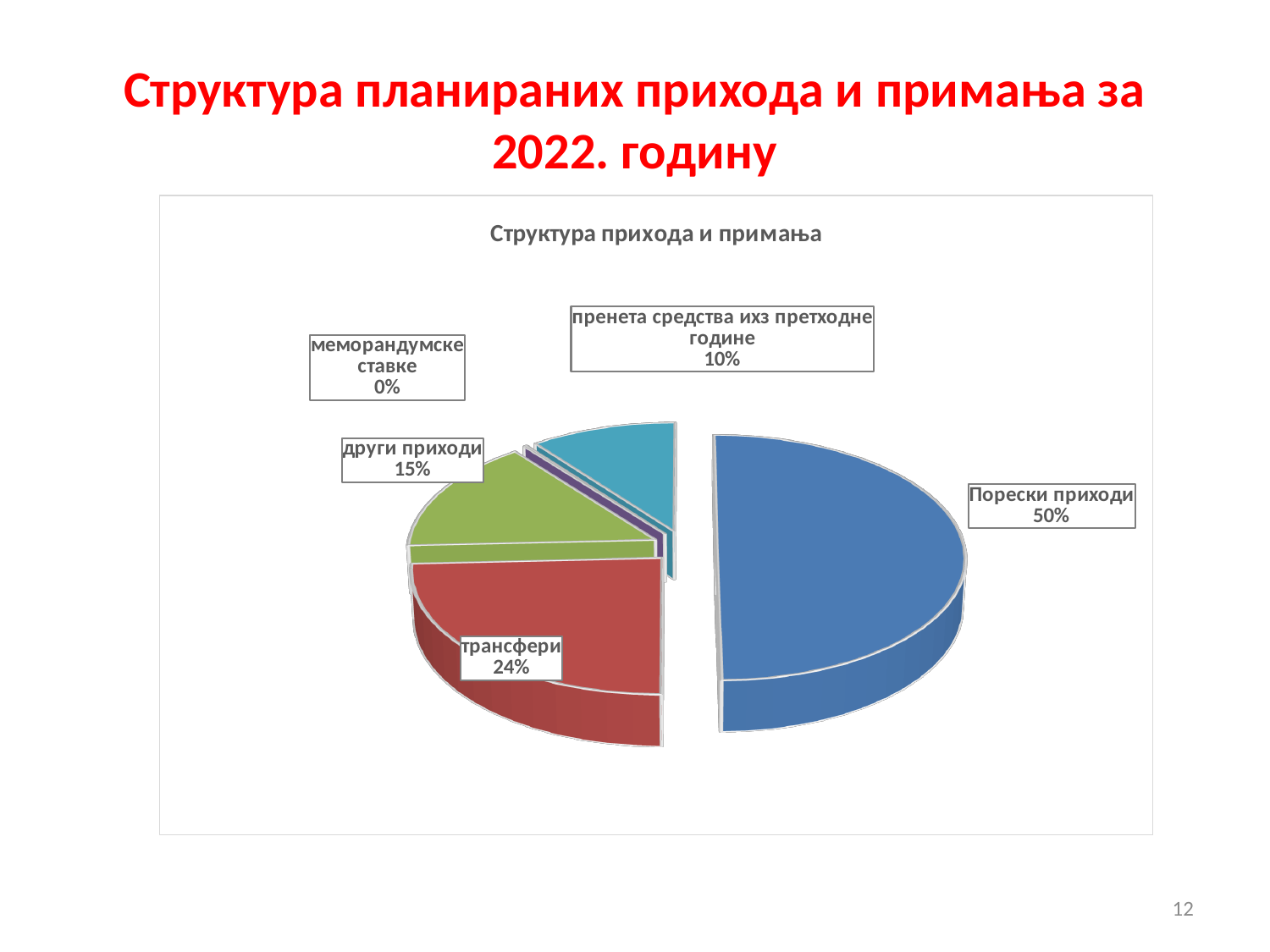
What share of the pie is трансфери? 24% Which category has the largest share of the pie? Порески приходи What share of the pie is пренета средства ихз претходне године? 10% Which is larger, други приходи or пренета средства ихз претходне године? други приходи What share of the pie is Порески приходи? 50% What share of the pie is меморандумске ставке? 0% What share of the pie is други приходи? 15% How many categories are shown in the pie chart? 5 What kind of chart is shown on the slide? pie chart Which category has the smallest share of the pie? меморандумске ставке What is the chart's title? Структура прихода и примања What is the difference in percentage points between Порески приходи and трансфери? 26